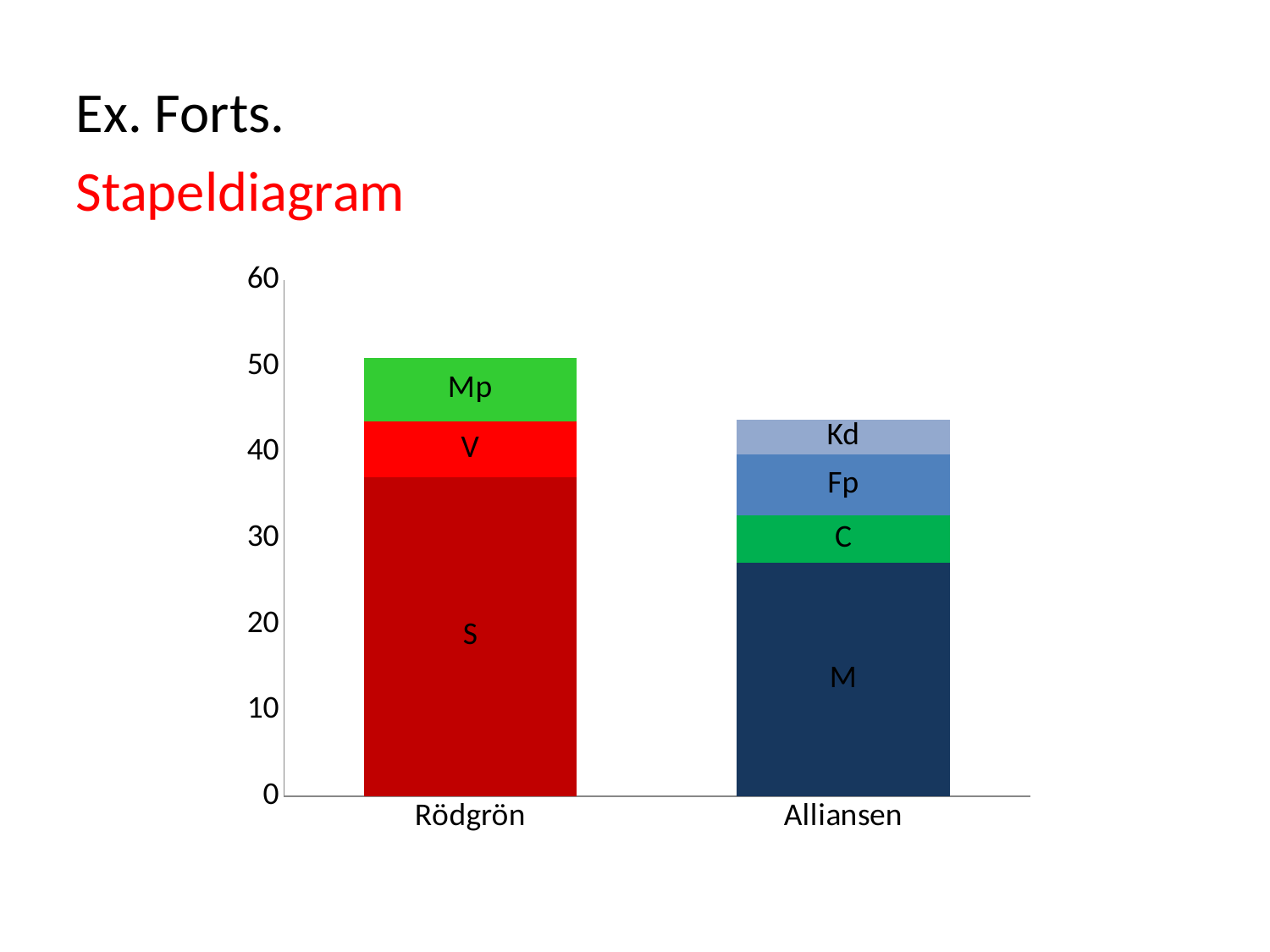
Is the total height of the Alliansen bar greater or less than 40? greater How many bars (categories) are shown on the x axis? 2 How many segments make up the Rödgrön bar? 3 What kind of chart is shown on the slide? Stacked bar chart Is the total height of the Alliansen bar greater or less than 50? less Is the top of the S segment in the Rödgrön bar greater or less than 30? greater What is the title of the chart shown in red on the slide? Stapeldiagram Which segment is at the bottom of the Alliansen bar? M How many segments make up the Alliansen bar? 4 Which segment is larger, S in the Rödgrön bar or M in the Alliansen bar? S Which bar is taller, Rödgrön or Alliansen? Rödgrön